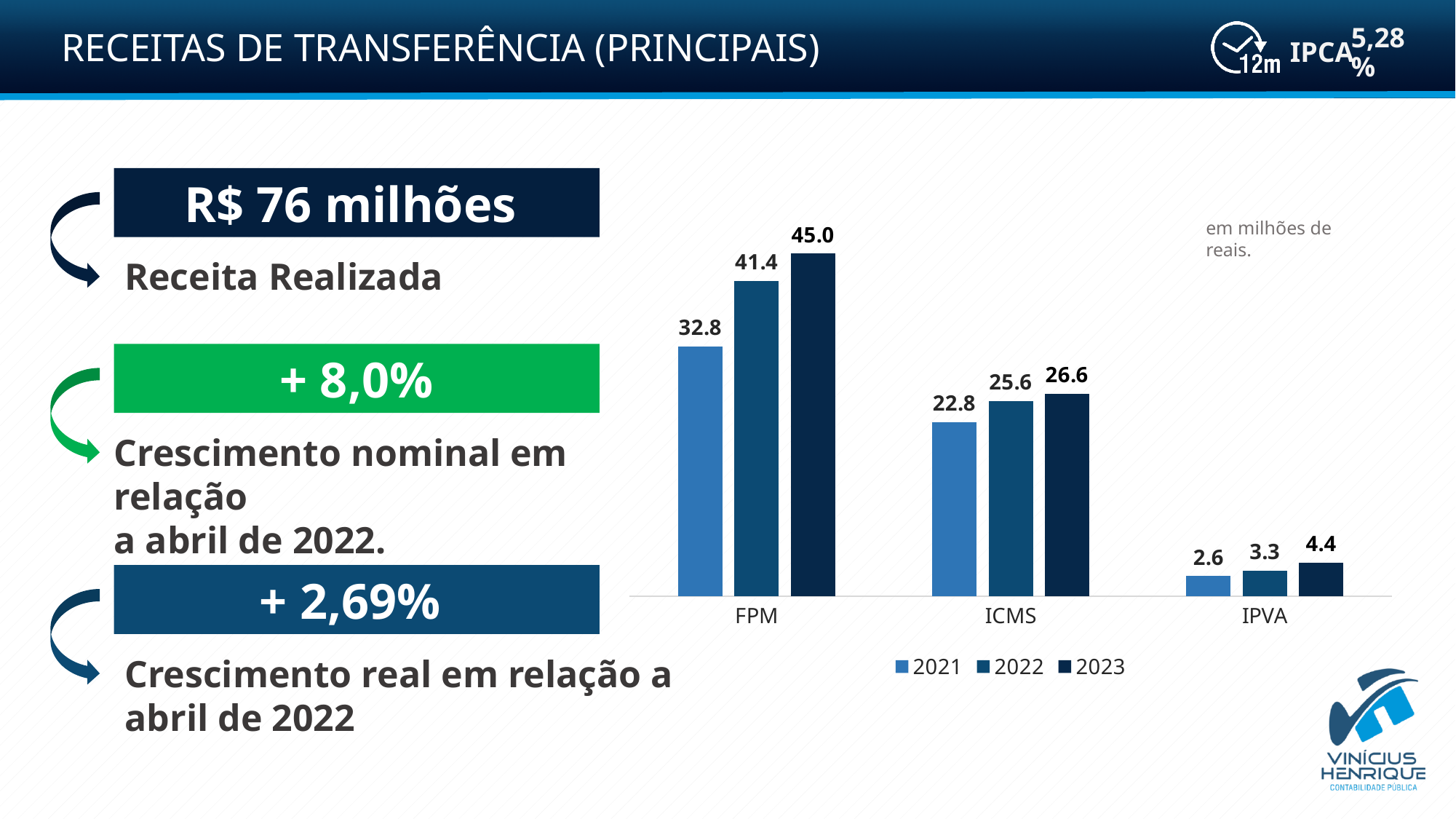
Which category has the lowest value in 2021? IPVA What is the value for IPVA in 2022? 3.3 What kind of chart is shown on the slide? Bar chart What is the difference between the ICMS values for 2022 and 2021? 2.8 What is the value for FPM in 2023? 45.0 What is the value for ICMS in 2021? 22.8 Do the IPVA values rise or fall from 2021 to 2023? Rise Which is larger, the 2022 value for FPM or the 2023 value for ICMS? FPM 2022 How many categories are shown on the x axis? 3 Which category has the highest value in 2023? FPM How many series does the legend list? 3 What is the difference between the FPM values for 2023 and 2021? 12.2